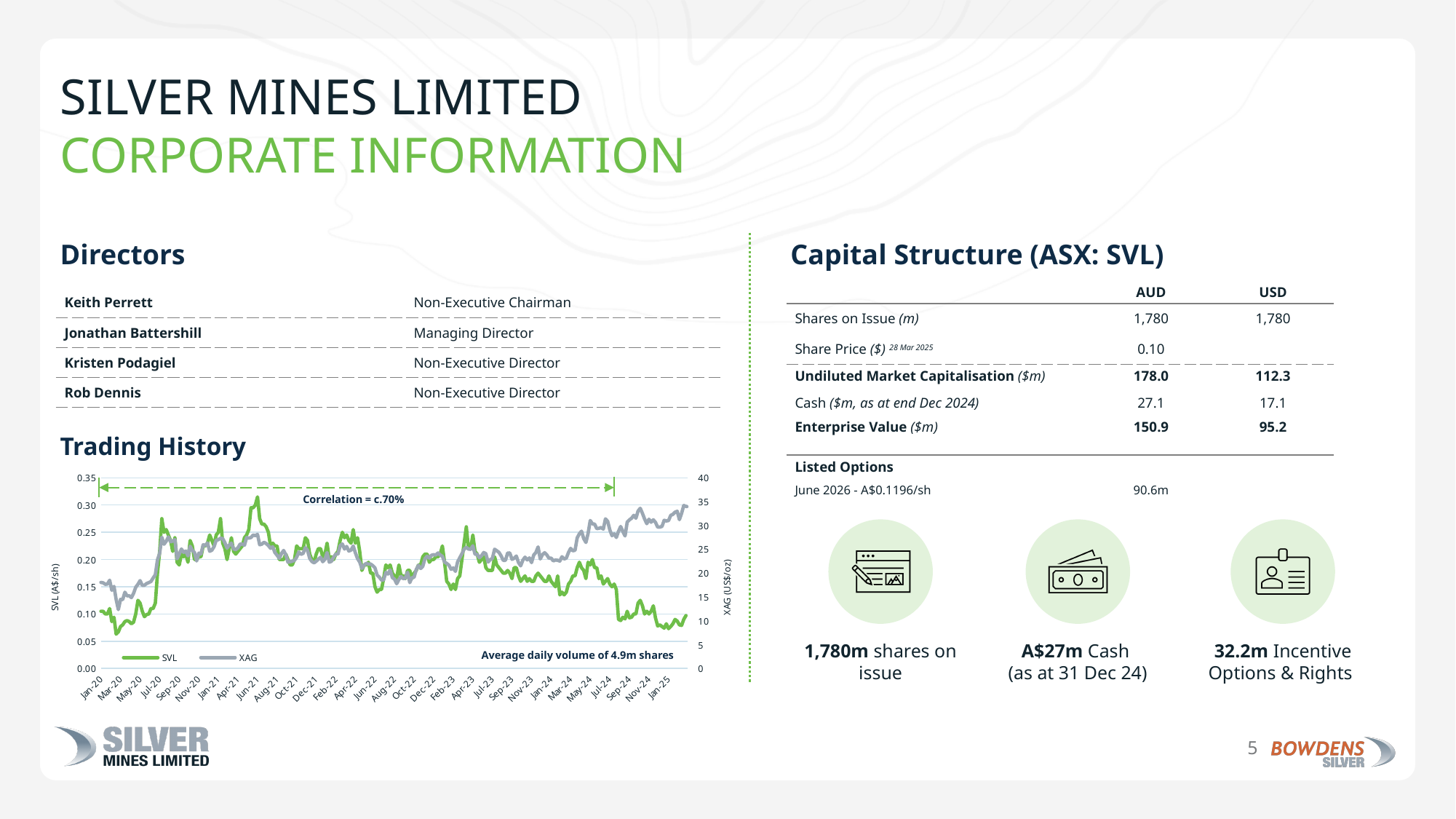
What correlation value is annotated on the Trading History chart? c.70% What is the first month label on the x axis of the Trading History chart? Jan-20 Around which month does the SVL series reach its highest point on the Trading History chart? Jun-21 What kind of chart is the Trading History chart? line chart On the Trading History chart, does the SVL series rise or fall between Jul-24 and Jan-25? fall Is the XAG value at Jan-25 on the Trading History chart greater or less than 30? greater How many series does the legend of the Trading History chart list? 2 Is the SVL value at Jan-25 on the Trading History chart greater or less than 0.15? less On the Trading History chart, does the XAG series rise or fall between Mar-24 and Jan-25? rise What are the two series named in the legend of the Trading History chart? SVL and XAG Is the SVL value at Jan-20 on the Trading History chart greater or less than 0.15? less